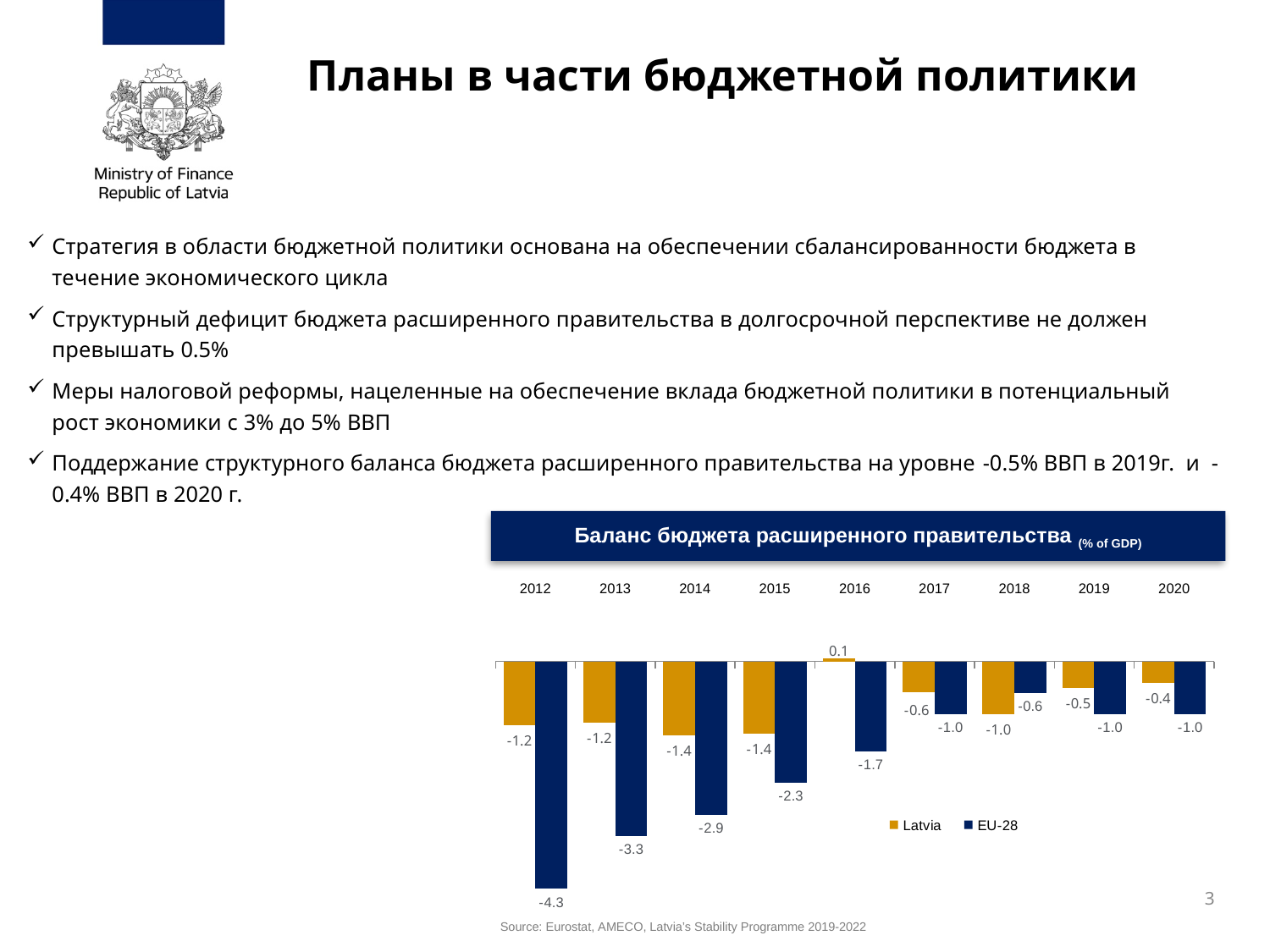
How many years are shown on the x axis? 9 In which year is the EU-28 value lowest? 2012 What is the value for Latvia in 2016? 0.1 In which year is the Latvia value highest? 2016 What is the value for Latvia in 2018? -1.0 Does the EU-28 value generally rise or fall from 2012 to 2017? Rise How many series does the legend list? 2 What kind of chart is shown on the slide? Bar chart What is the difference between the EU-28 value and the Latvia value in 2013? 2.1 What is the value for EU-28 in 2015? -2.3 Which is larger in 2018, the Latvia value or the EU-28 value? EU-28 What is the value for EU-28 in 2012? -4.3